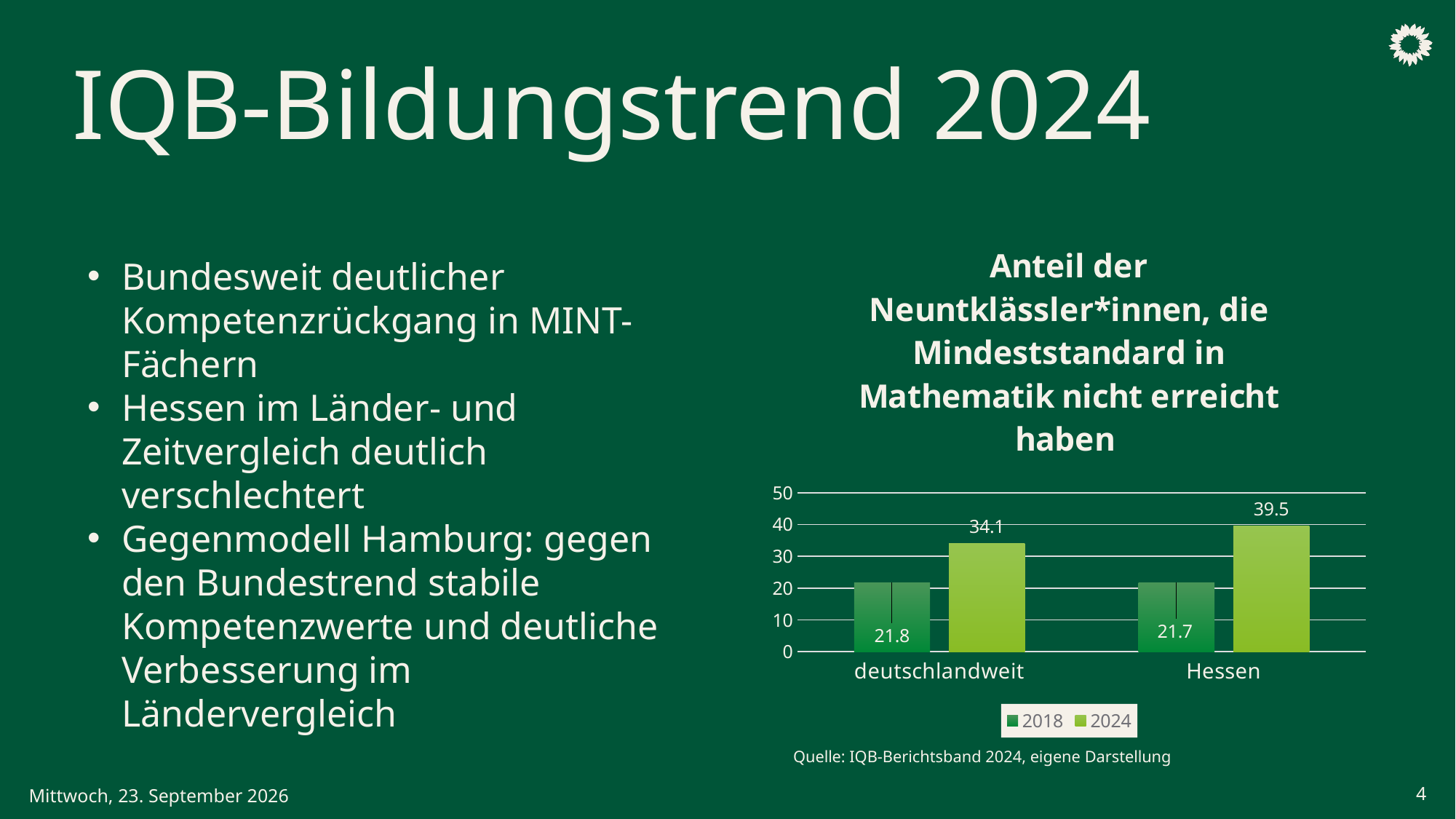
Which category has the highest 2024 value? Hessen What is the 2018 value for deutschlandweit? 21.8 Which series does the lighter green colour represent in the legend? 2024 Which is larger: the 2024 value for deutschlandweit or the 2024 value for Hessen? Hessen What is the 2018 value for Hessen? 21.7 What is the difference between the 2024 and 2018 values for Hessen? 17.8 What is the 2024 value for deutschlandweit? 34.1 What kind of chart is shown on the slide? bar chart What is the difference between the 2024 values for Hessen and deutschlandweit? 5.4 What is the 2024 value for Hessen? 39.5 How many series does the legend list? 2 How many categories are shown on the x axis? 2